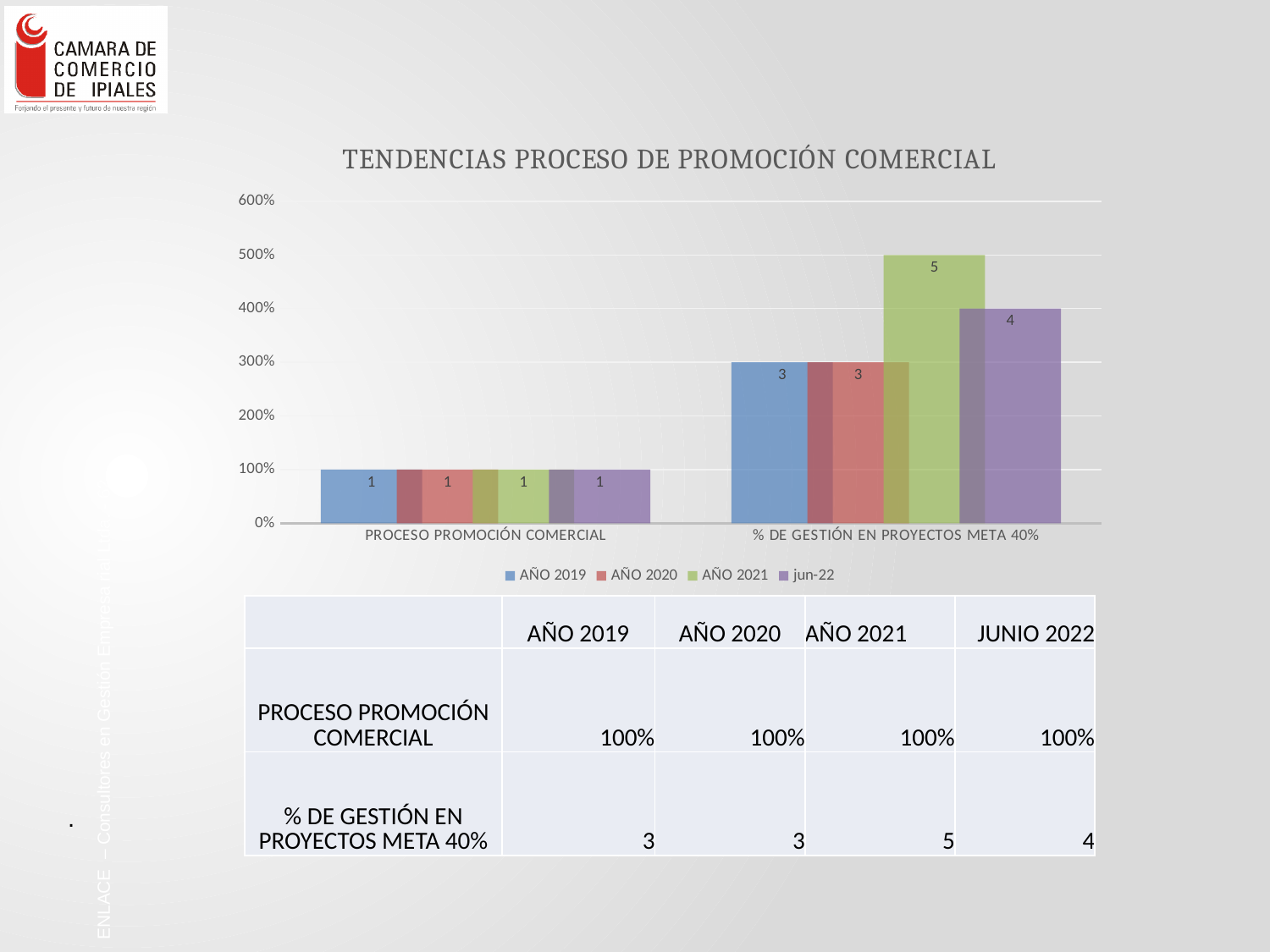
What kind of chart is shown on the slide? bar chart What is the title of the chart? TENDENCIAS PROCESO DE PROMOCIÓN COMERCIAL Is the jun-22 bar for % DE GESTIÓN EN PROYECTOS META 40% greater or less than 300%? greater How many series does the legend list? 4 What is the difference between the AÑO 2021 and AÑO 2019 data labels in the % DE GESTIÓN EN PROYECTOS META 40% category? 2 How many categories are shown on the x axis? 2 In the % DE GESTIÓN EN PROYECTOS META 40% category, which is larger: AÑO 2021 or jun-22? AÑO 2021 What is the highest value shown on the vertical axis? 600% What is the data label for AÑO 2019 in the PROCESO PROMOCIÓN COMERCIAL category? 1 What is the data label for jun-22 in the % DE GESTIÓN EN PROYECTOS META 40% category? 4 What is the data label for AÑO 2021 in the % DE GESTIÓN EN PROYECTOS META 40% category? 5 Which series has the highest value in the % DE GESTIÓN EN PROYECTOS META 40% category? AÑO 2021